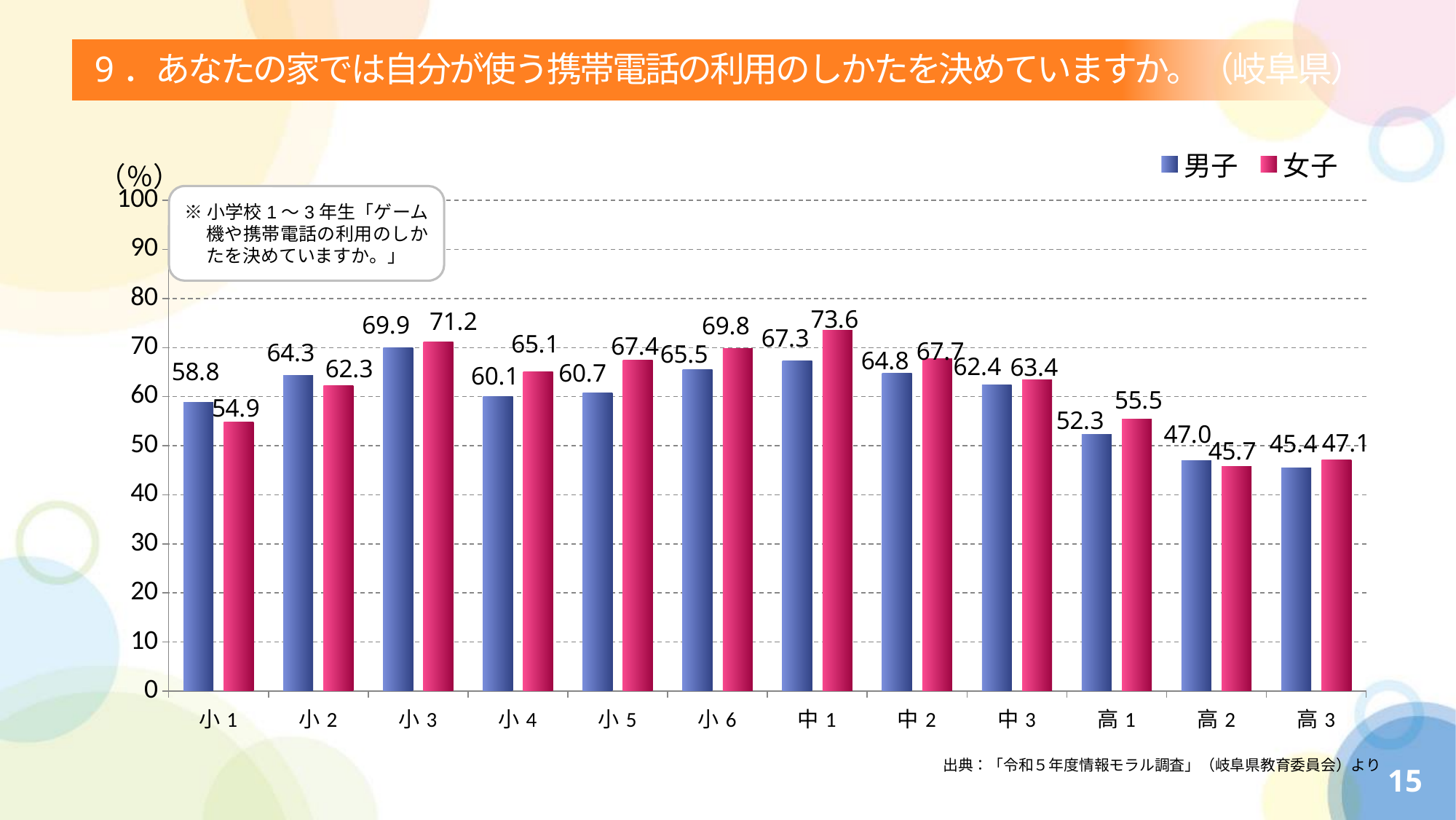
What is the difference between the 女子 and 男子 values at 小5? 6.7 Which category has the highest value for 男子? 小3 Which colour represents 女子 in the chart? Pink How many series does the legend list? 2 How many grade categories are shown on the x axis? 12 Which category has the highest value for 女子? 中1 At 高2, which is larger, the 男子 value or the 女子 value? 男子 What is the value for 女子 at 中1? 73.6 What is the value for 男子 at 高2? 47.0 What kind of chart is shown on the slide? Bar chart What is the value for 男子 at 小1? 58.8 Which category has the lowest value for 男子? 高3